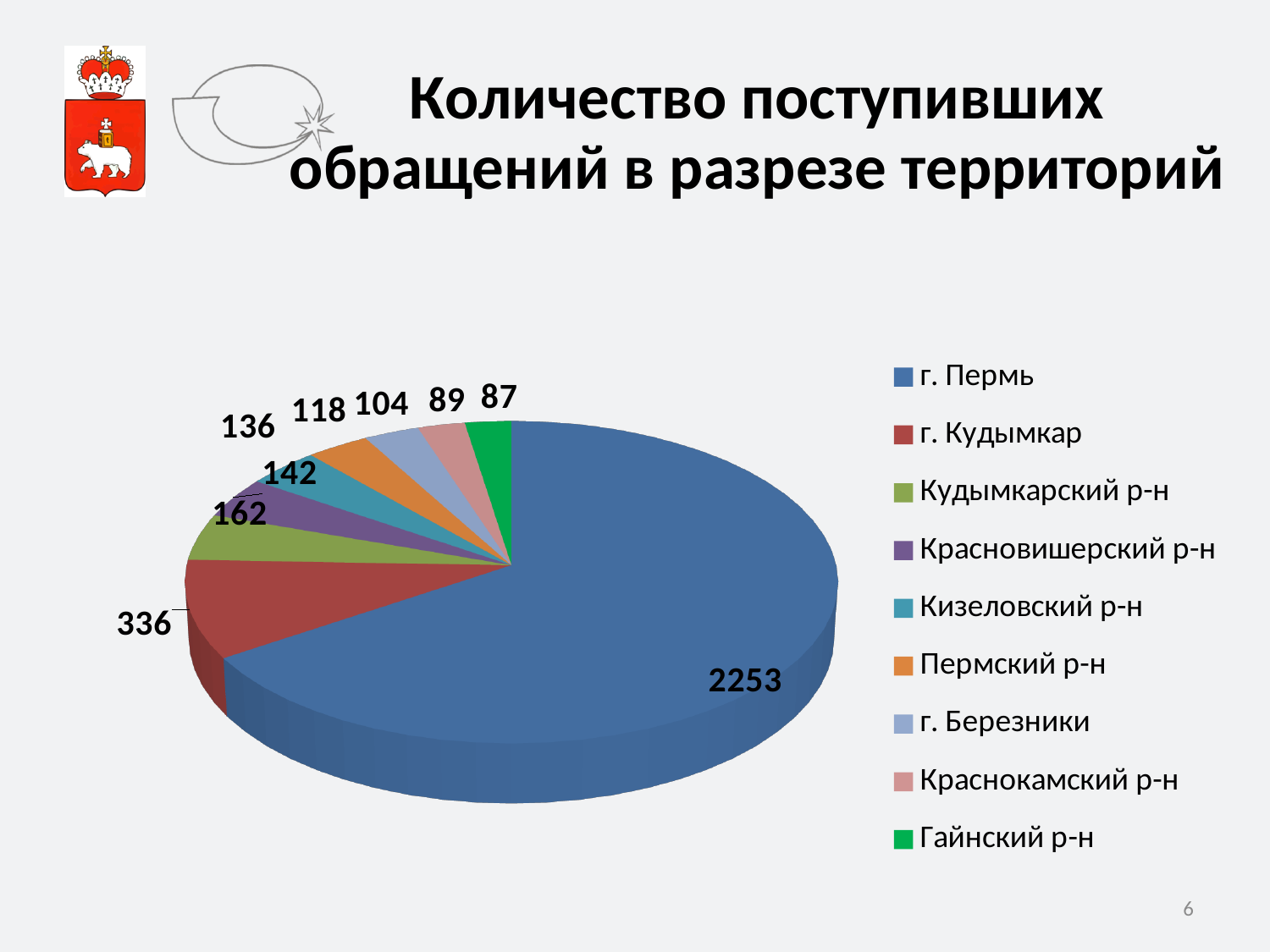
What type of chart is shown on the slide? pie chart Which is larger, the value for Кудымкарский р-н or the value for Красновишерский р-н? Кудымкарский р-н What is the difference between the values for г. Пермь and г. Кудымкар? 1917 What is the value for г. Кудымкар? 336 Which territory has the largest number of appeals? г. Пермь What is the total of all values shown in the pie chart? 3427 How many categories does the pie chart have? 9 What is the title of the chart on the slide? Количество поступивших обращений в разрезе территорий What is the value for Кизеловский р-н? 136 Which territory has the smallest number of appeals? Гайнский р-н What is the value for г. Пермь? 2253 What is the value for Гайнский р-н? 87